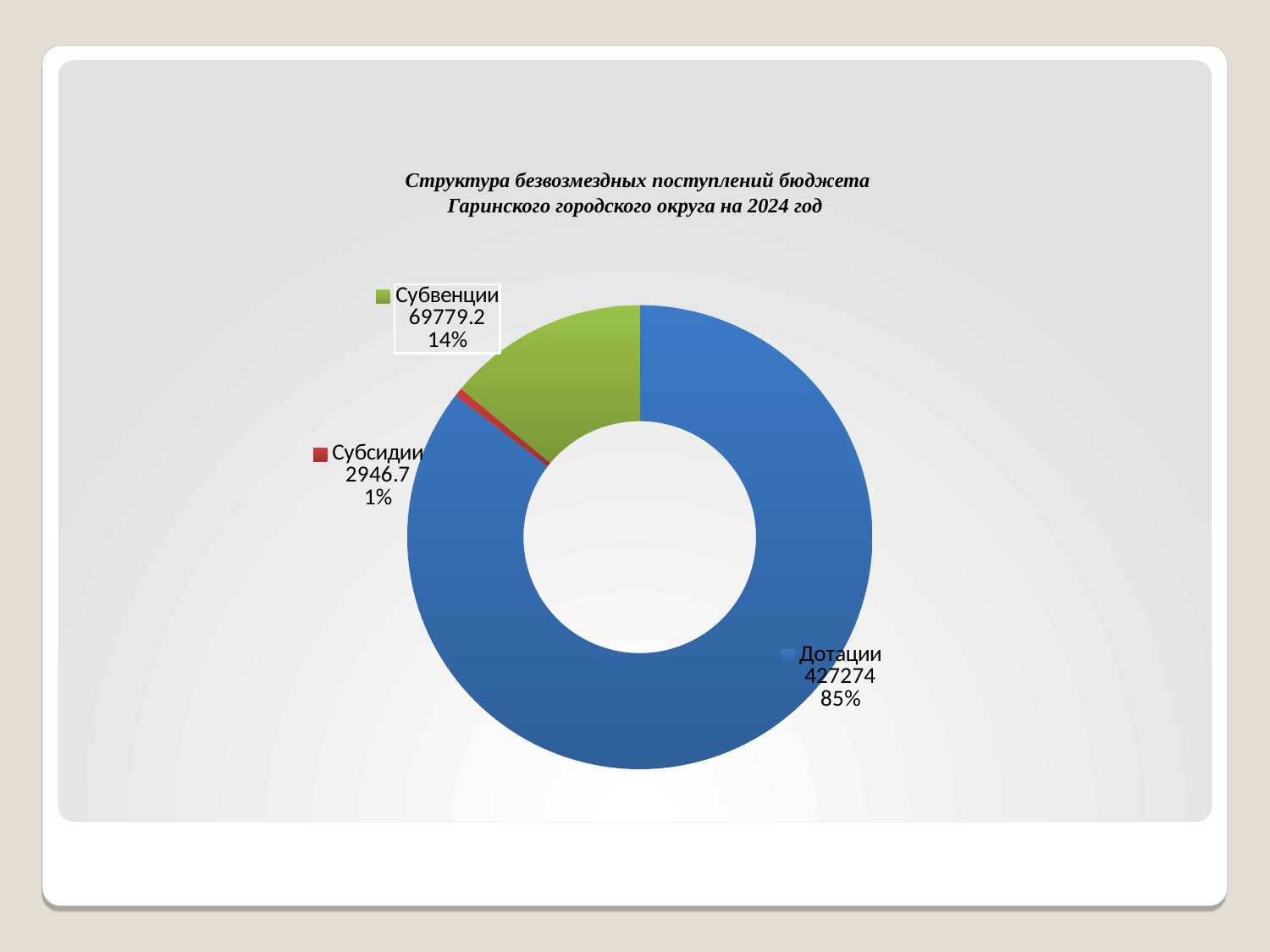
How many categories are shown in the chart? 3 Which is larger, Субвенции or Субсидии? Субвенции What share of the chart does Дотации represent? 85% What share of the chart does Субвенции represent? 14% Which category has the largest slice? Дотации What kind of chart is shown on the slide? Doughnut (pie) chart What is the difference between the values for Субвенции and Субсидии? 66832.5 What is the value for Дотации? 427274 What is the value for Субсидии? 2946.7 What share of the chart does Субсидии represent? 1% Which category has the smallest slice? Субсидии What is the value for Субвенции? 69779.2